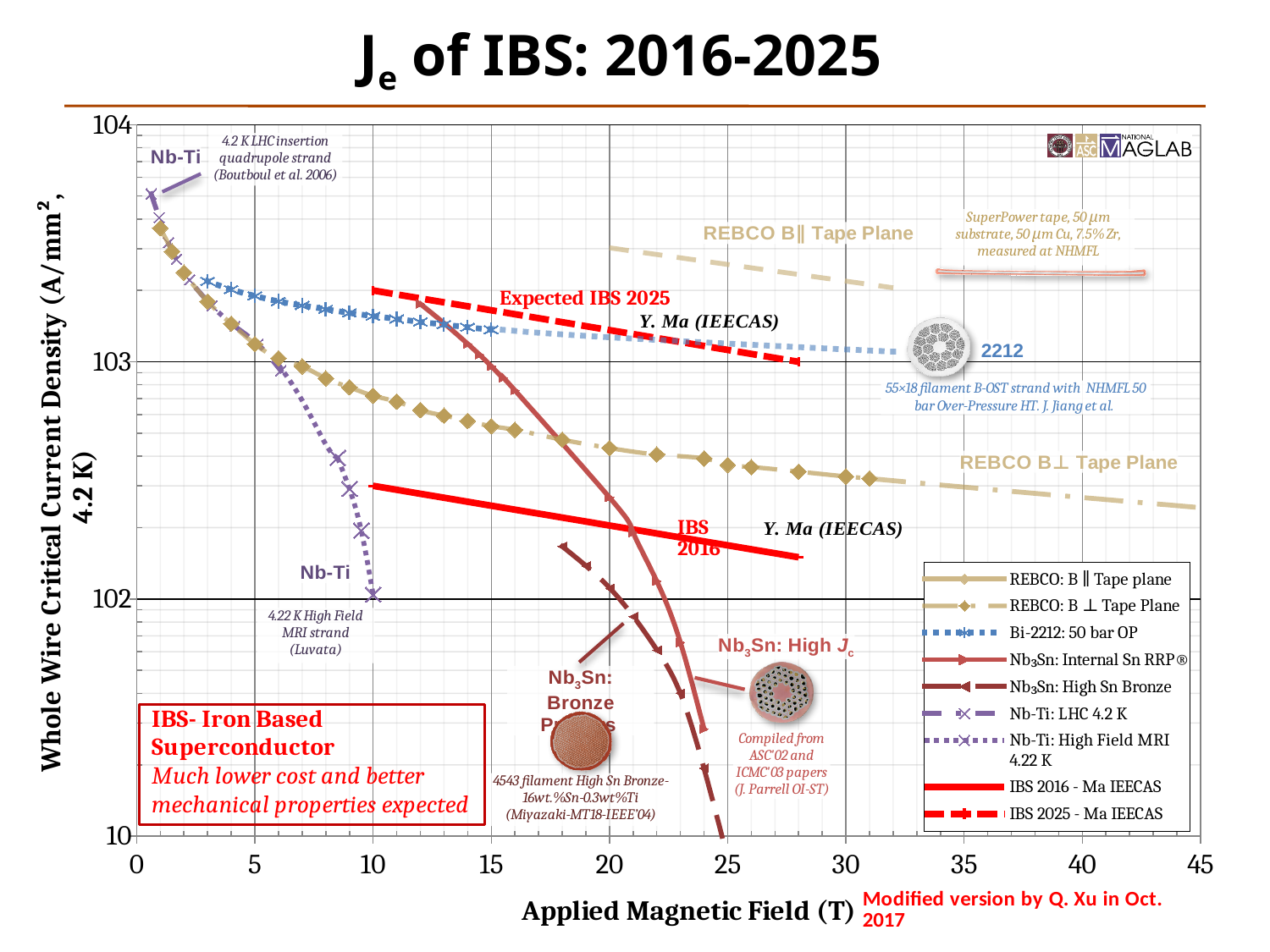
Is the value of the Expected IBS 2025 line at 10 T greater or less than 10^3? greater What is the label of the x axis? Applied Magnetic Field (T) At 20 T, which is higher: the REBCO B∥ Tape Plane line or the IBS 2016 line? REBCO B∥ Tape Plane At 10 T, which is higher: the Expected IBS 2025 line or the IBS 2016 line? Expected IBS 2025 What is the title of the chart? Je of IBS: 2016-2025 Is the value of the Nb3Sn: Internal Sn RRP line at 20 T greater or less than 10^3? less Is the value of the IBS 2016 line at 10 T greater or less than 10^3? less What kind of chart is shown on the slide? line chart Does the IBS 2016 line rise or fall as the applied magnetic field increases? fall How many series does the legend list? 9